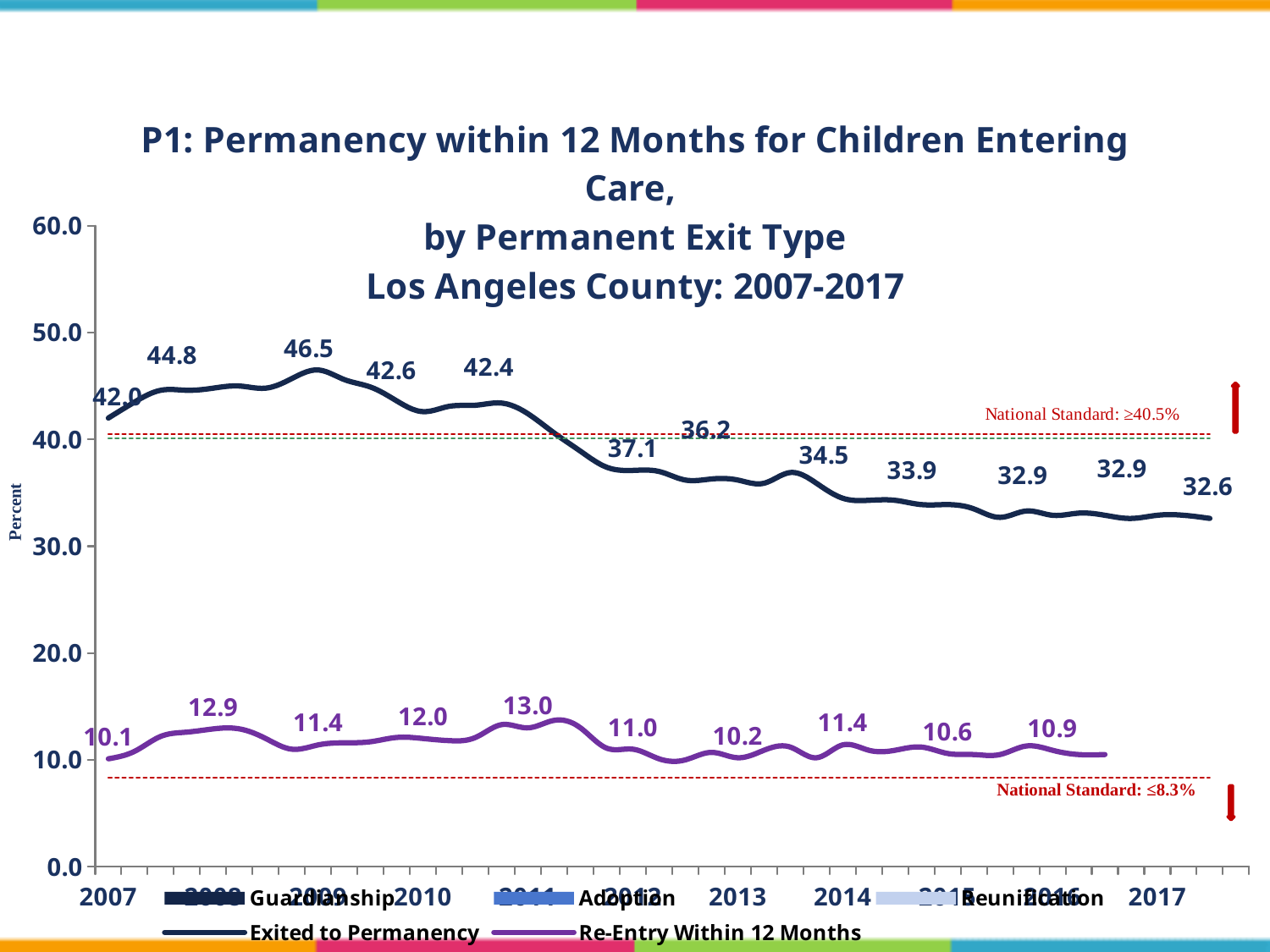
How many data labels are printed on the Exited to Permanency line? 12 What kind of chart is shown on the slide? line chart What is the first labeled value (at 2007) on the Exited to Permanency line? 42.0 Which line is higher throughout the chart, Exited to Permanency or Re-Entry Within 12 Months? Exited to Permanency What is the first labeled value (at 2007) on the Re-Entry Within 12 Months line? 10.1 What is the highest labeled value on the Exited to Permanency line? 46.5 Does the Exited to Permanency line rise or fall overall from 2007 to 2017? fall Is the Exited to Permanency value at 2017 greater or less than 40.0? less What National Standard is shown for the Exited to Permanency line? ≥40.5% What is the highest labeled value on the Re-Entry Within 12 Months line? 13.0 What is the difference between the highest (46.5) and lowest (32.6) labeled values on the Exited to Permanency line? 13.9 What is the lowest labeled value on the Exited to Permanency line? 32.6